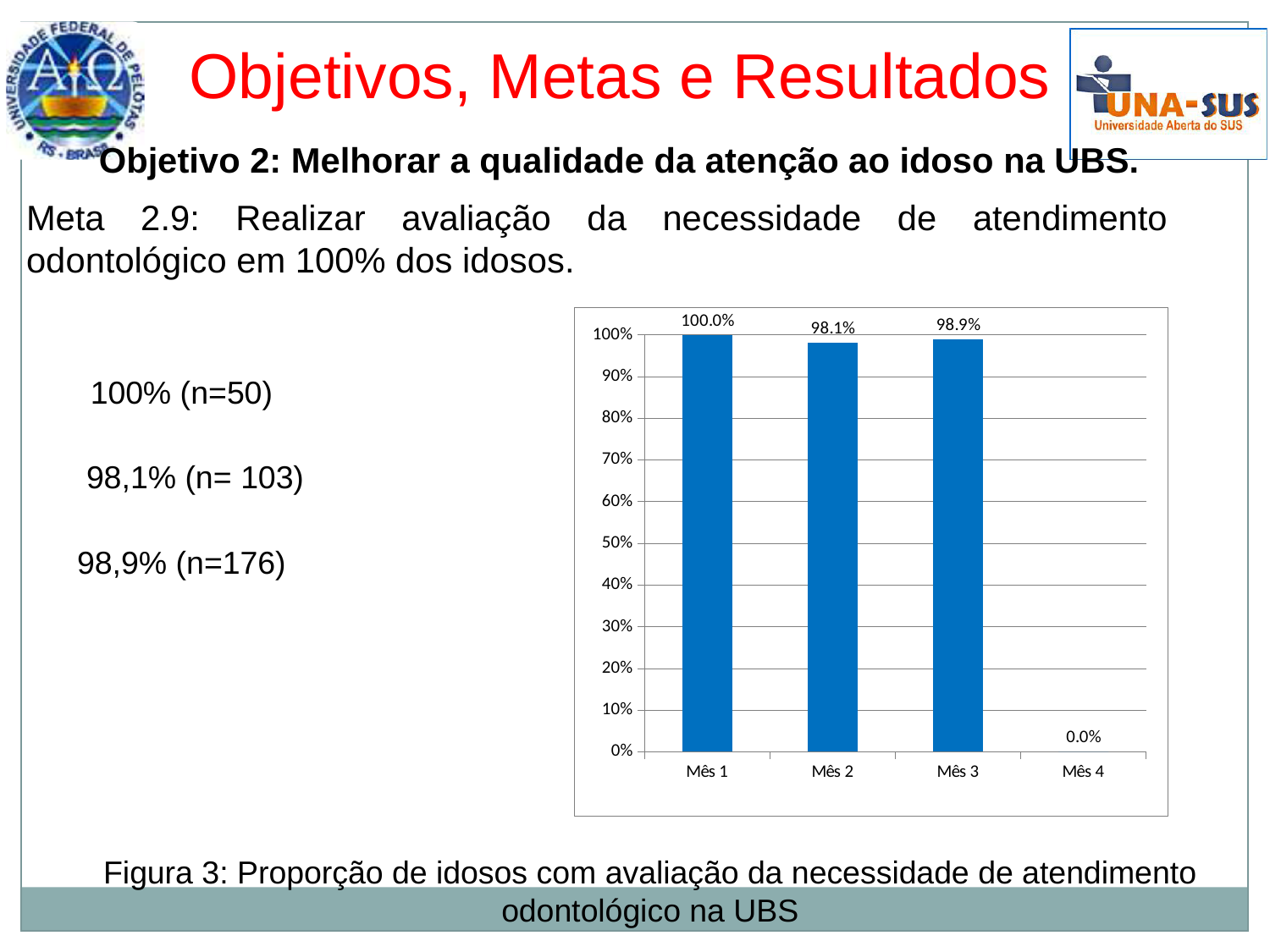
What is the value for Mês 1? 100.0% Which month has the lowest value? Mês 4 Which is larger, the value for Mês 2 or the value for Mês 3? Mês 3 Which month has the highest value? Mês 1 What is the value for Mês 3? 98.9% Is the value for Mês 2 greater or less than 90%? greater What is the value for Mês 2? 98.1% What is the value for Mês 4? 0.0% How many months are shown on the x axis? 4 What is the difference between the values for Mês 3 and Mês 2? 0.8% What is the difference between the values for Mês 1 and Mês 2? 1.9% What kind of chart is shown on the slide? Bar chart